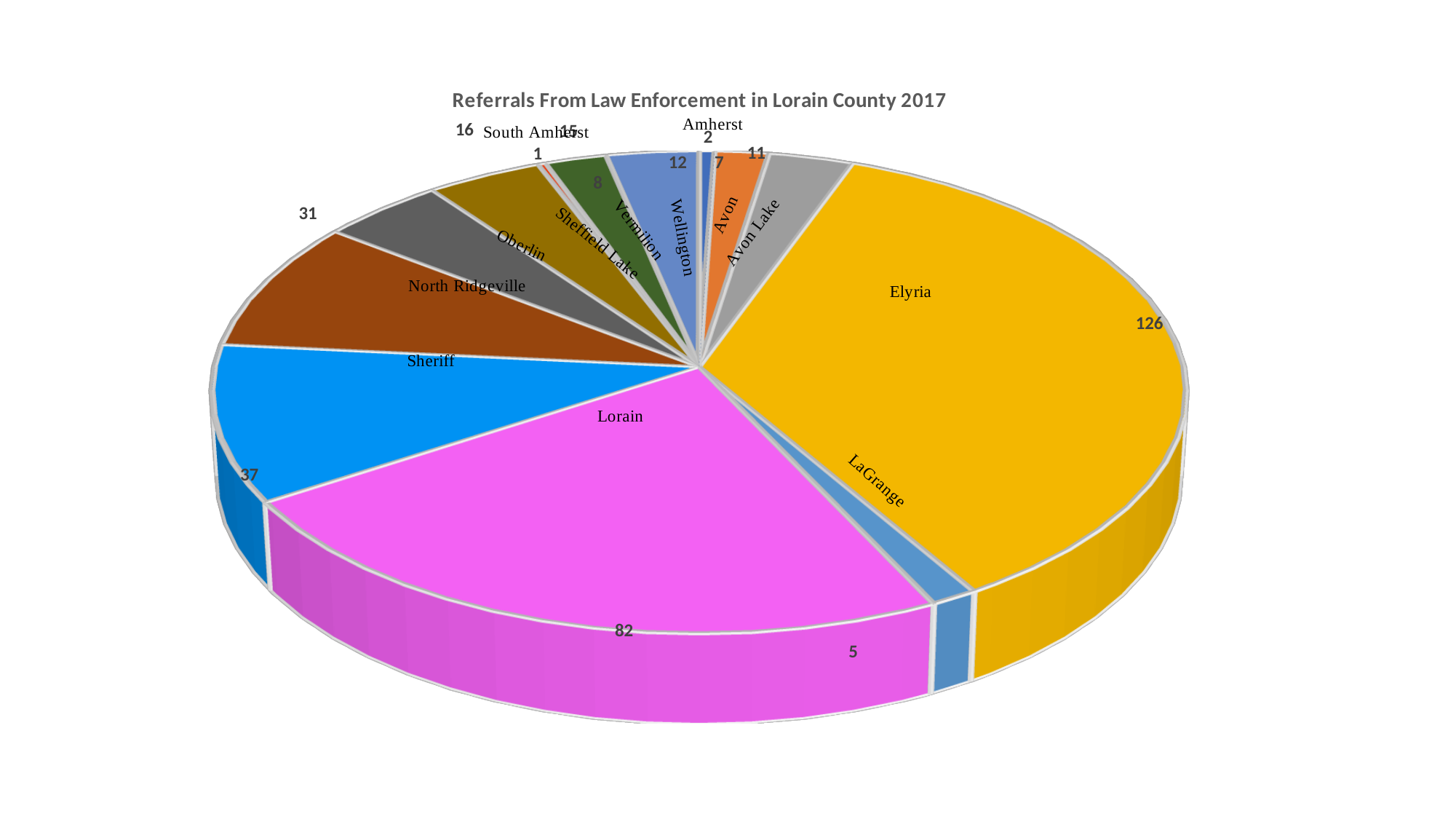
Which agency has the smallest slice of the pie? South Amherst What kind of chart is shown on the slide? pie chart Which agency has the largest slice of the pie? Elyria How many referrals came from Elyria? 126 What is the title of the chart? Referrals From Law Enforcement in Lorain County 2017 How many referrals came from Lorain? 82 What is the value for the Sheriff slice? 37 What is the difference between the Elyria and Lorain values? 44 How many slices does the pie chart have? 13 What is the value for North Ridgeville? 31 How many referrals came from Amherst? 2 What is the value for Avon Lake? 11